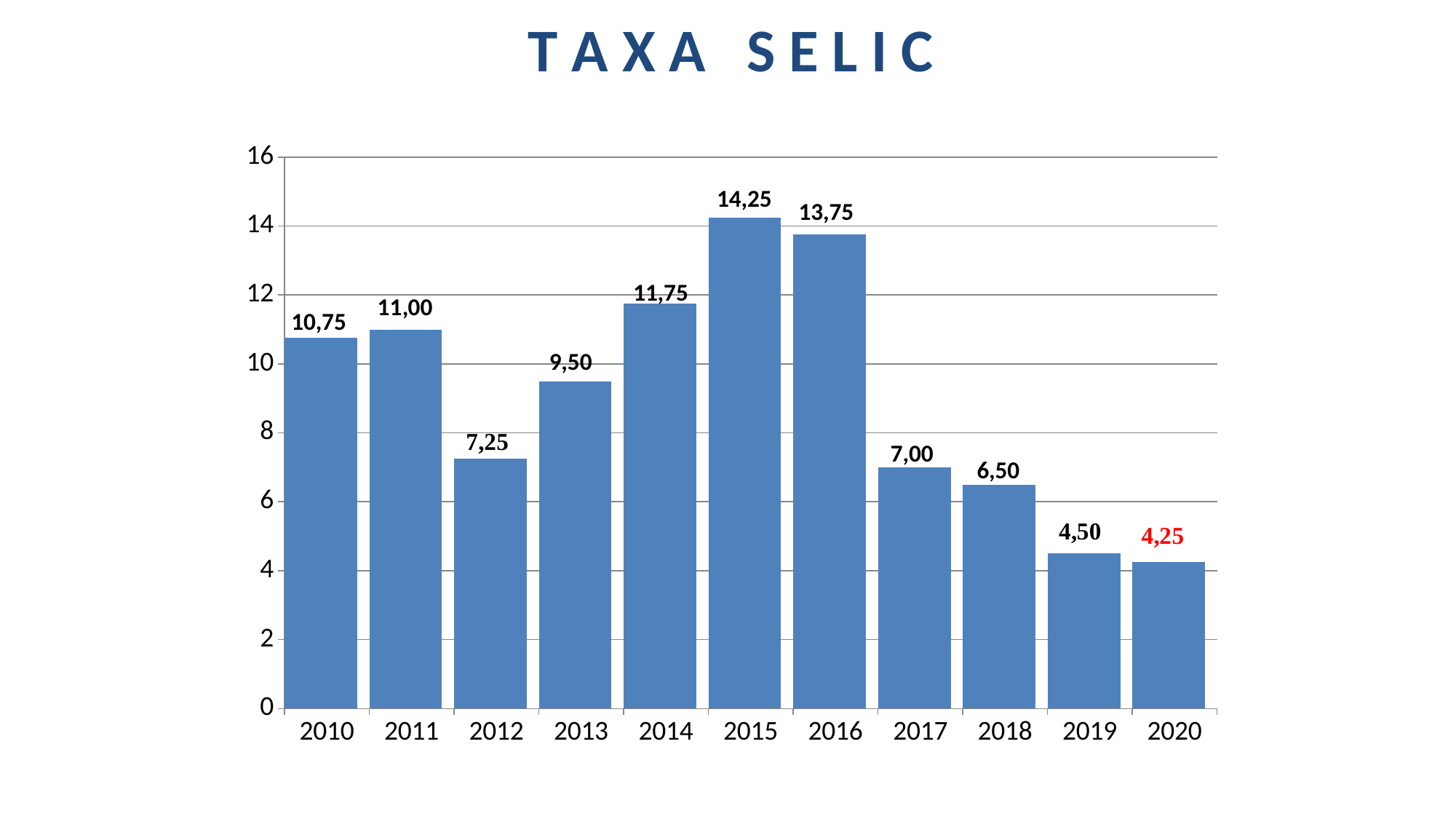
What is the title of the chart? TAXA SELIC Which is larger, the value for 2011 or the value for 2013? 2011 What is the value for 2020? 4,25 Which year has the lowest value? 2020 What is the value for 2015? 14,25 Which year has the highest value? 2015 What is the value for 2012? 7,25 What kind of chart is this? bar chart What is the difference between the values for 2015 and 2016? 0,50 How many years are shown on the x axis? 11 What is the difference between the values for 2019 and 2020? 0,25 Is the value for 2014 greater or less than 10? greater